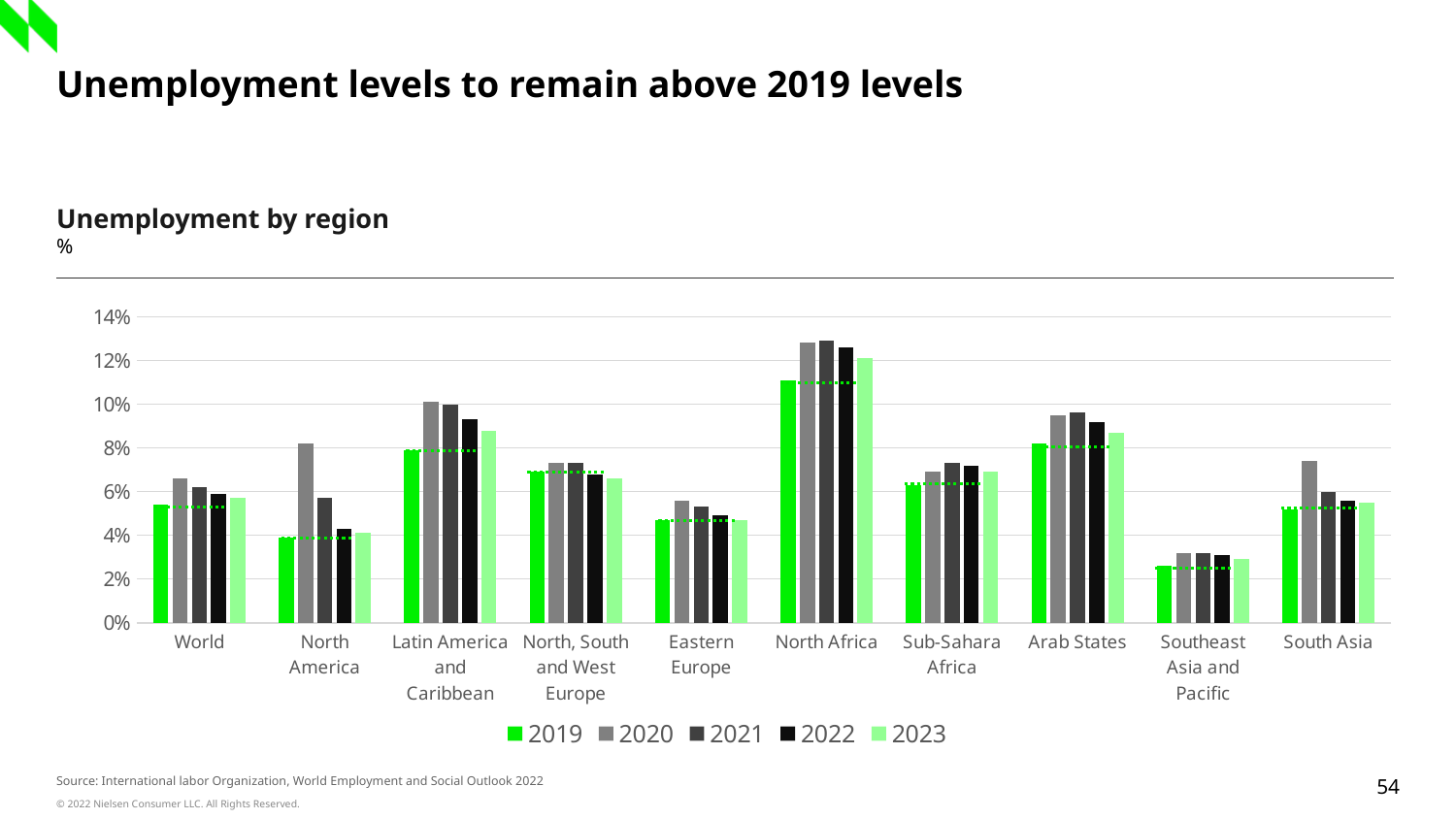
Is the 2020 value for North America greater or less than 6%? greater For World, which is larger, the 2019 value or the 2020 value? 2020 How many regions are shown on the x axis? 10 Which region has the highest unemployment value for 2020? North Africa For North America, do the values rise or fall from 2020 to 2023? fall Is the 2021 value for North Africa greater or less than 12%? greater What is the title of the chart? Unemployment by region Is the 2019 value for Southeast Asia and Pacific greater or less than 4%? less Which is larger, the 2020 value for Latin America and Caribbean or the 2020 value for Arab States? Latin America and Caribbean What kind of chart is shown on the slide? Bar chart Which region has the lowest unemployment value for 2019? Southeast Asia and Pacific How many series does the legend list? 5